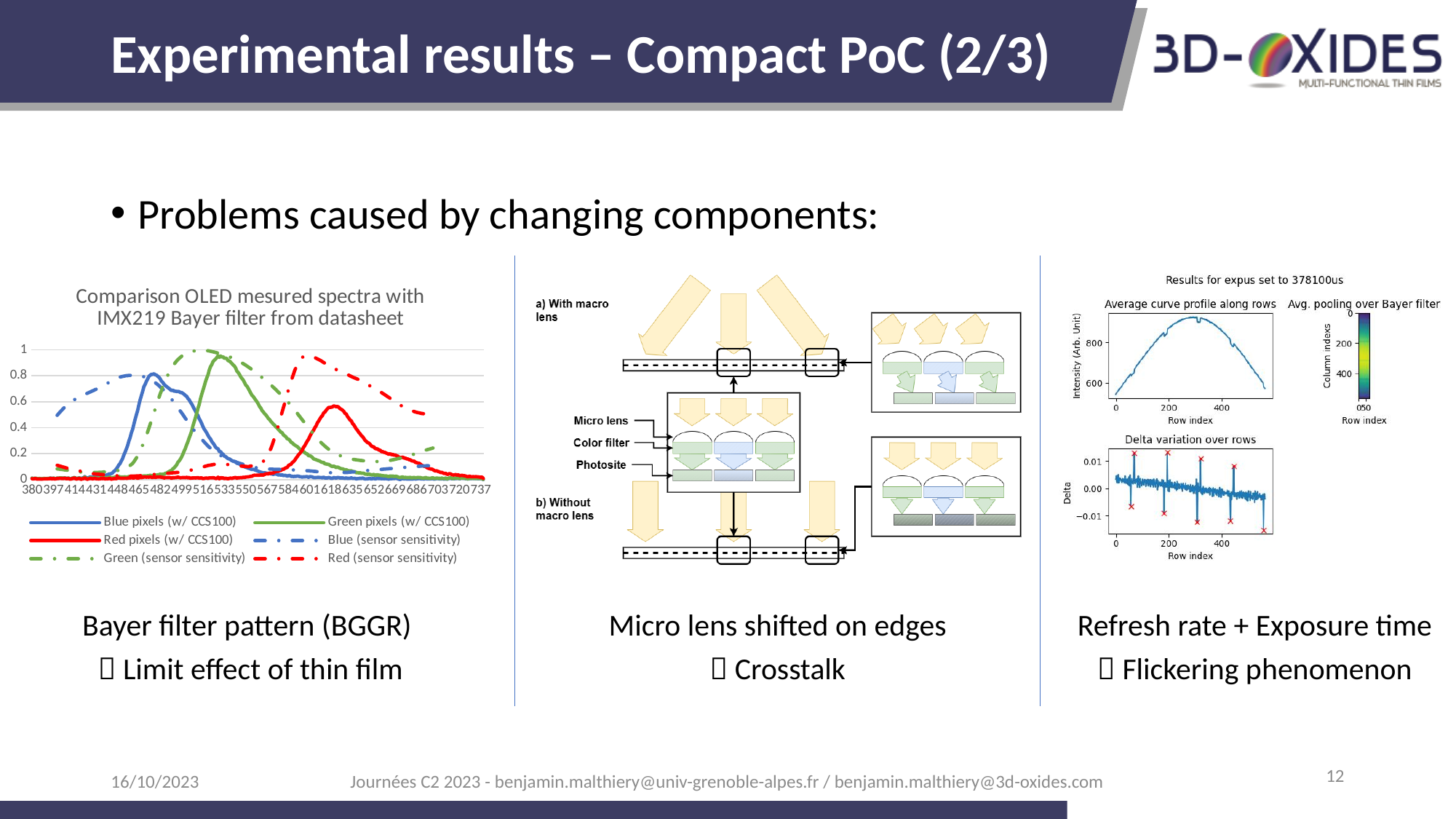
In the left chart, which series reaches a higher peak: 'Green pixels (w/ CCS100)' or 'Red pixels (w/ CCS100)'? Green pixels (w/ CCS100) In the left chart, which of the three solid-line series (w/ CCS100) has the lowest peak? Red pixels (w/ CCS100) What kind of chart is the left chart titled 'Comparison OLED mesured spectra with IMX219 Bayer filter from datasheet'? Line chart In the left chart, what is the highest value shown on the y axis? 1 In the left chart, which series peaks at a longer wavelength: 'Blue pixels (w/ CCS100)' or 'Red pixels (w/ CCS100)'? Red pixels (w/ CCS100) In the left chart, is the peak value of the 'Green pixels (w/ CCS100)' series greater or less than 0.8? greater In the left chart, is the peak value of the 'Red (sensor sensitivity)' series greater or less than 0.8? greater How many series does the legend of the left chart list? 6 What is the title of the left chart? Comparison OLED mesured spectra with IMX219 Bayer filter from datasheet In the left chart, is the peak value of the 'Red pixels (w/ CCS100)' series greater or less than 0.8? less In the left chart, which of the three solid-line series (w/ CCS100) reaches the highest peak? Green pixels (w/ CCS100)